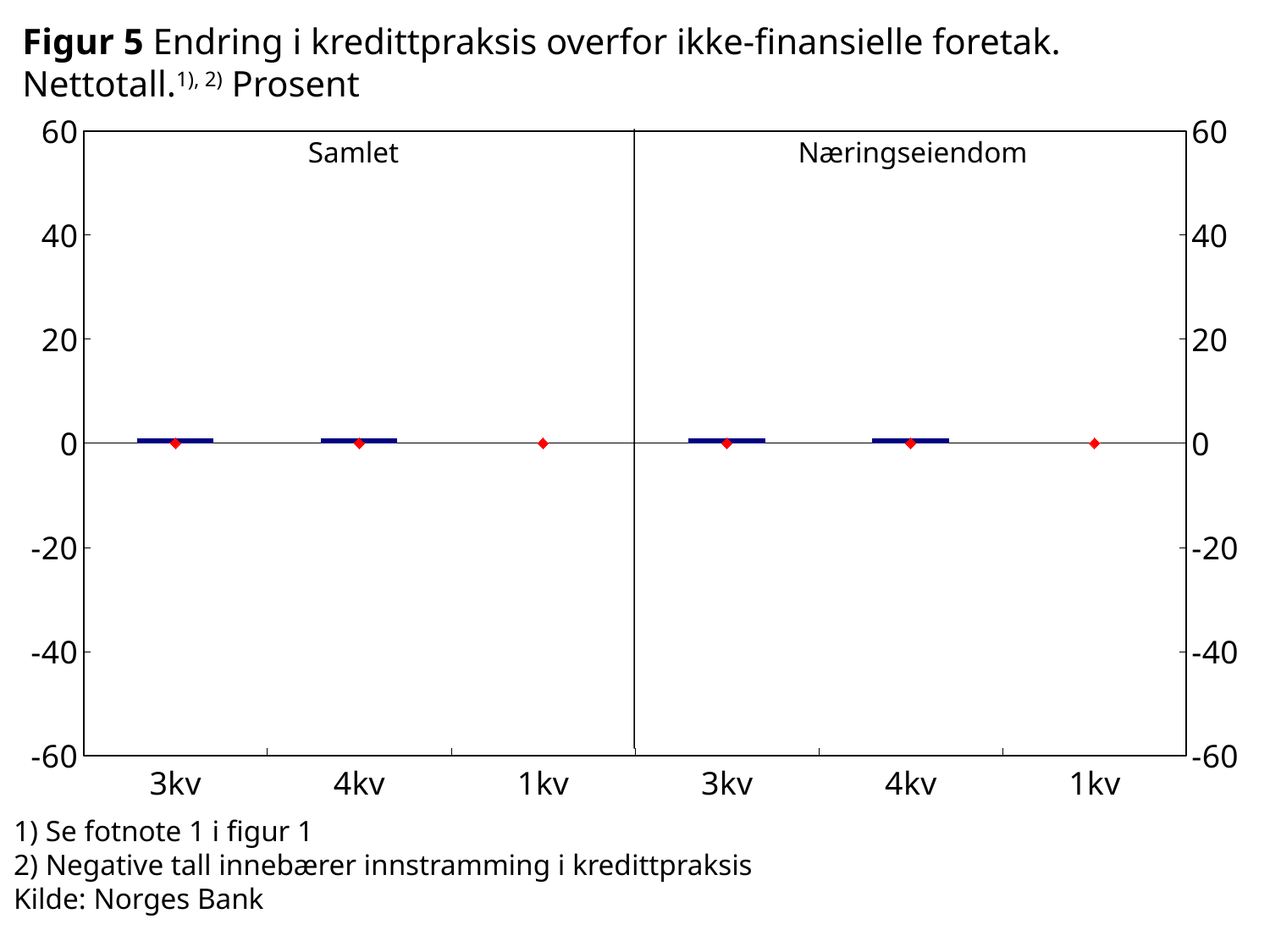
How many quarter categories are shown in the Næringseiendom panel? 3 What is the highest value shown on the vertical axis? 60 What kind of chart is shown on the slide? bar chart In the Samlet panel, is the value for 4kv greater or less than -20? greater How many quarter categories are shown in the Samlet panel? 3 What is the source given for the chart? Norges Bank In the Samlet panel, is the value for 3kv greater or less than 20? less In the Næringseiendom panel, is the value for 1kv greater or less than -20? greater What are the titles of the two panels in the chart? Samlet and Næringseiendom In the Samlet panel, what value does the 1kv point land on? 0 In the Næringseiendom panel, what value does the 1kv point land on? 0